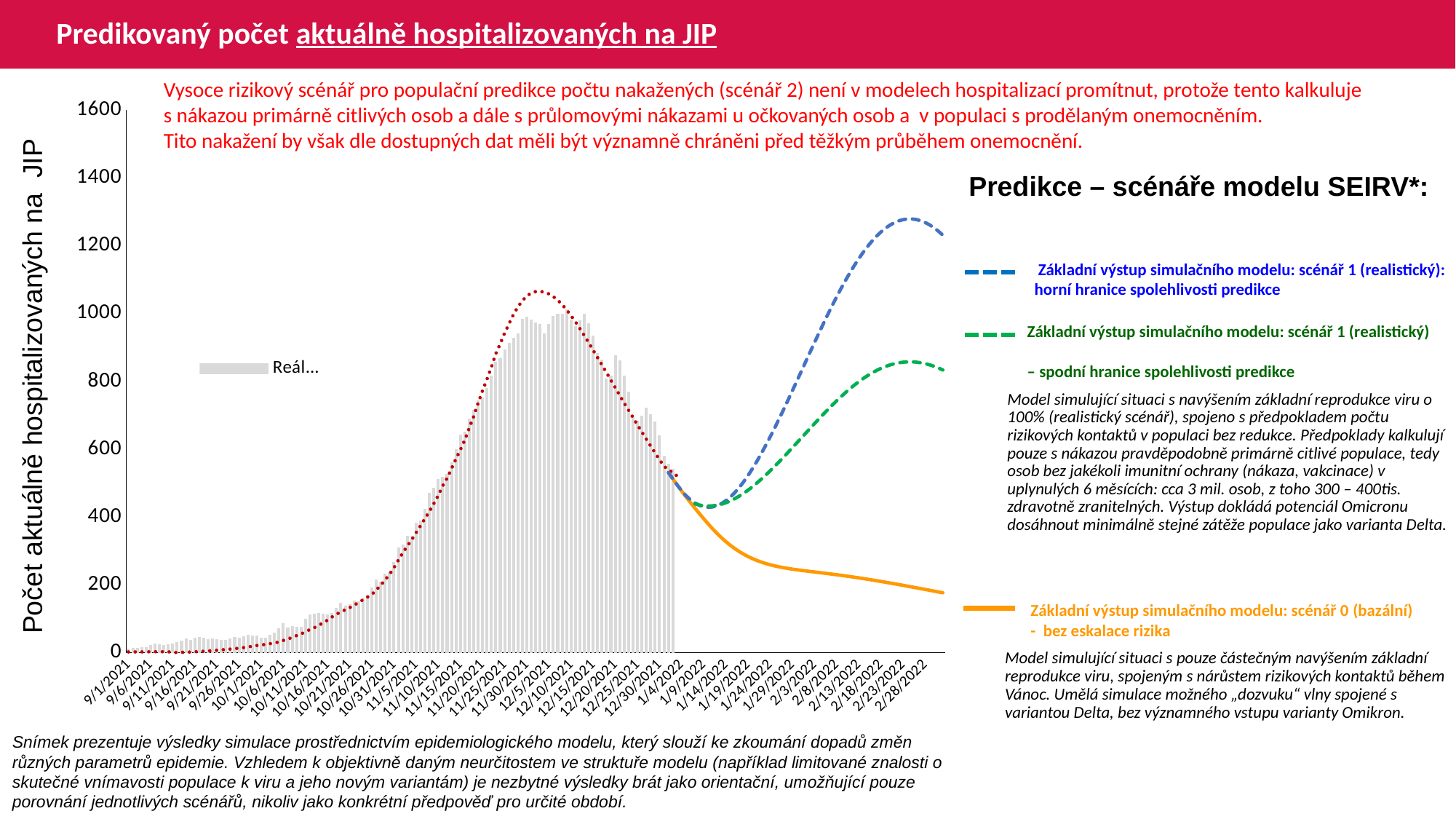
Is the peak of the blue dashed line (around 2/23/2022) greater or less than 1400? less Is the peak value of the grey bars (around 12/5/2021) greater or less than 1200? less Is the peak of the green dashed line (around 2/23/2022) greater or less than 1000? less What is the highest tick value shown on the vertical axis? 1600 Does the orange line rise or fall between 1/9/2022 and 2/28/2022? Fall What kind of chart is shown on the slide? Bar chart combined with line series At 2/28/2022, which line has the larger value: the blue dashed line or the orange line? Blue dashed line What is the label of the vertical axis of the chart? Počet aktuálně hospitalizovaných na JIP What is the title of the chart on the slide? Predikovaný počet aktuálně hospitalizovaných na JIP